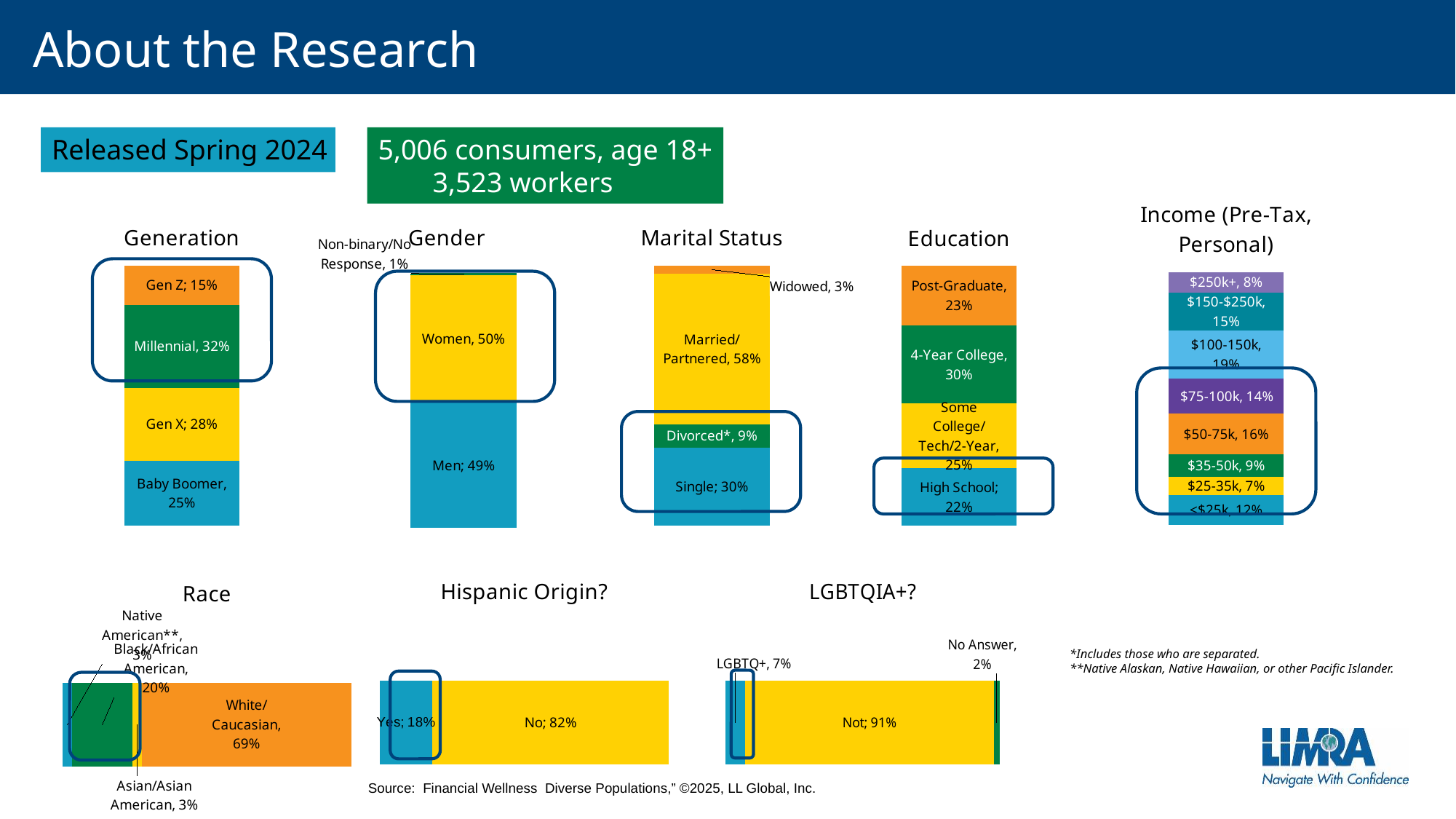
In the Generation chart, which generation has the largest share? Millennial What type of chart is used for the LGBTQIA+? breakdown? Stacked bar chart In the Race chart, what percentage is White/Caucasian? 69% In the Education chart, which is larger, Post-Graduate or High School? Post-Graduate In the Gender chart, what percentage is Men? 49% How many income bands are shown in the Income (Pre-Tax, Personal) chart? 8 In the Income (Pre-Tax, Personal) chart, what percentage is $100-150k? 19% In the Marital Status chart, which category has the smallest share? Widowed In the Marital Status chart, what is the difference between Married/Partnered and Single? 28% In the Education chart, what percentage is 4-Year College? 30% In the Generation chart, what percentage is Millennial? 32% In the Hispanic Origin? chart, what percentage answered Yes? 18%